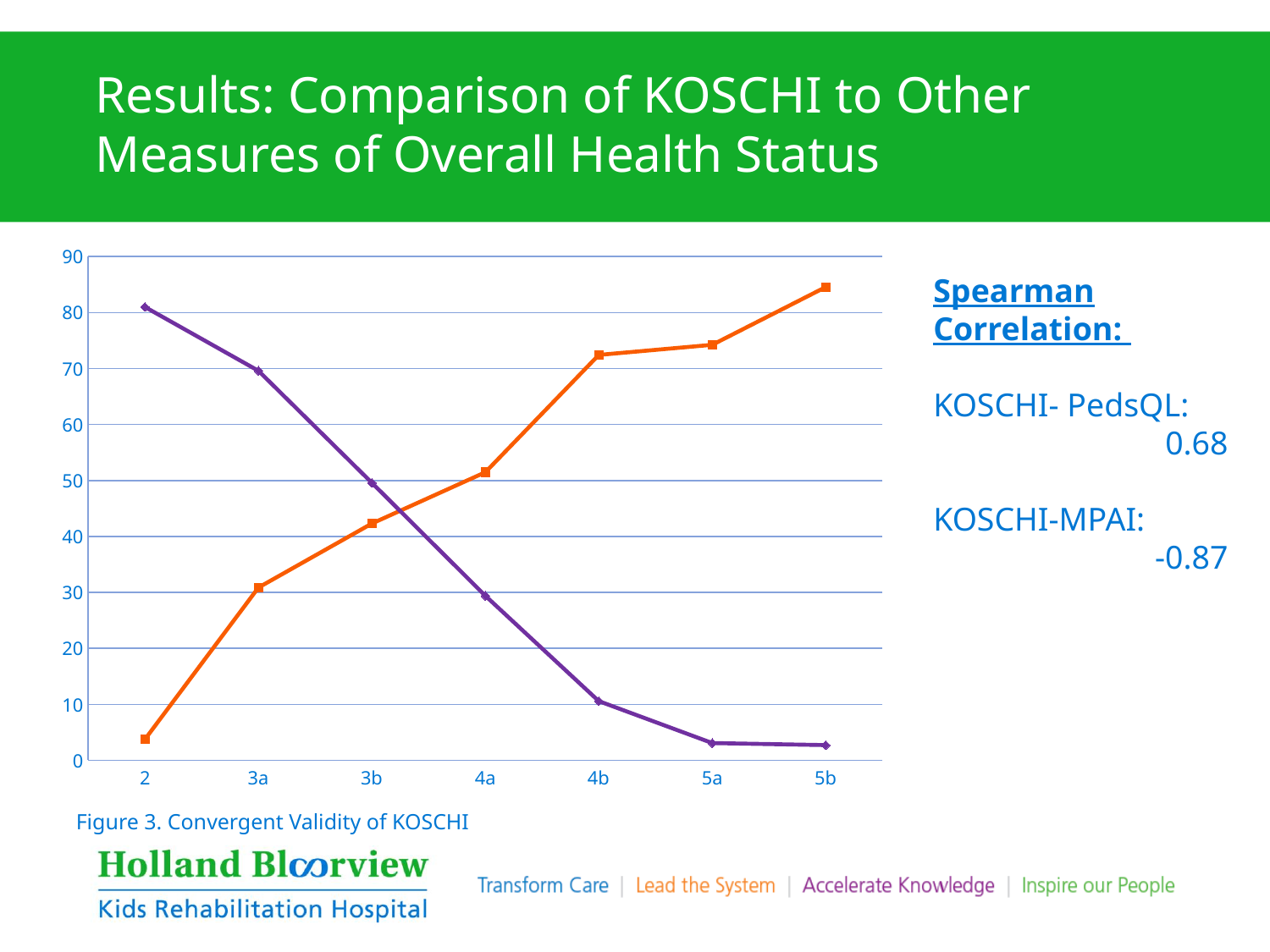
At which x-axis category does the orange line reach its highest value? 5b Is the value of the purple line at 5b greater or less than 10? less What kind of chart is shown on the slide? line chart At category 4a, which line has the higher value, the purple line or the orange line? orange line Is the value of the orange line at 5b greater or less than 80? greater Does the orange line rise or fall as you move from 2 to 5b along the x axis? rise What is the figure caption shown below the chart? Figure 3. Convergent Validity of KOSCHI Is the value of the orange line at 2 greater or less than 10? less Does the purple line rise or fall as you move from 2 to 5b along the x axis? fall How many categories are shown on the x axis of the chart? 7 At category 2, which line has the higher value, the purple line or the orange line? purple line